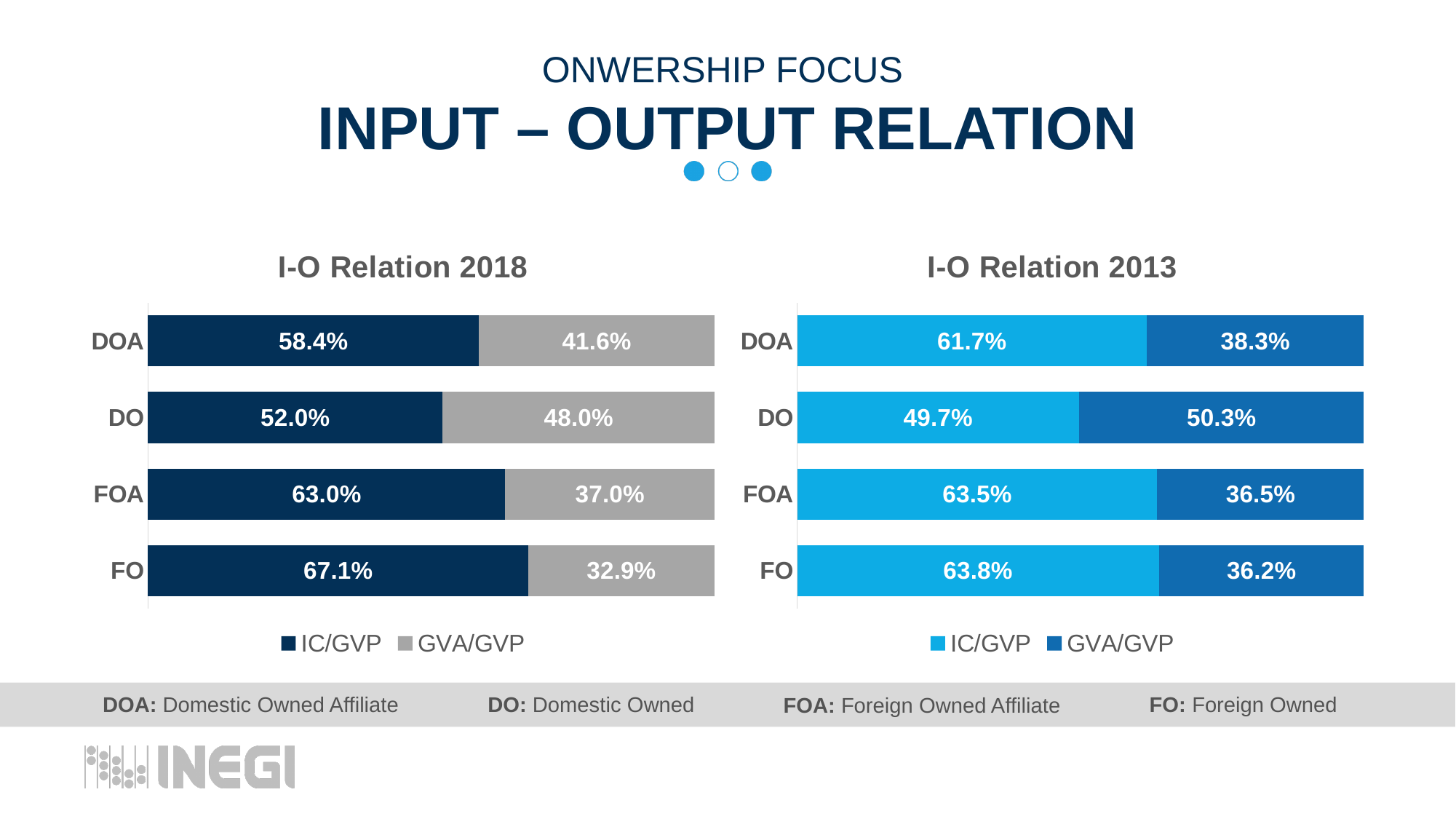
What kind of chart is the I-O Relation 2018 chart? Stacked bar chart In the I-O Relation 2018 chart, what is the GVA/GVP value for DOA? 41.6% In the I-O Relation 2018 chart, what is the IC/GVP value for FO? 67.1% How many categories are shown in the I-O Relation 2018 chart? 4 In the I-O Relation 2013 chart, what is the total of the DOA bar? 100.0% In the I-O Relation 2013 chart, what is the IC/GVP value for FOA? 63.5% In the I-O Relation 2018 chart, which category has the highest IC/GVP value? FO In the I-O Relation 2013 chart, which is larger for DOA: IC/GVP or GVA/GVP? IC/GVP In the I-O Relation 2013 chart, what is the GVA/GVP value for DO? 50.3% How many series does the legend of the I-O Relation 2013 chart list? 2 In the I-O Relation 2013 chart, which category has the lowest IC/GVP value? DO In the I-O Relation 2018 chart, what is the difference between the IC/GVP values for FO and DO? 15.1%